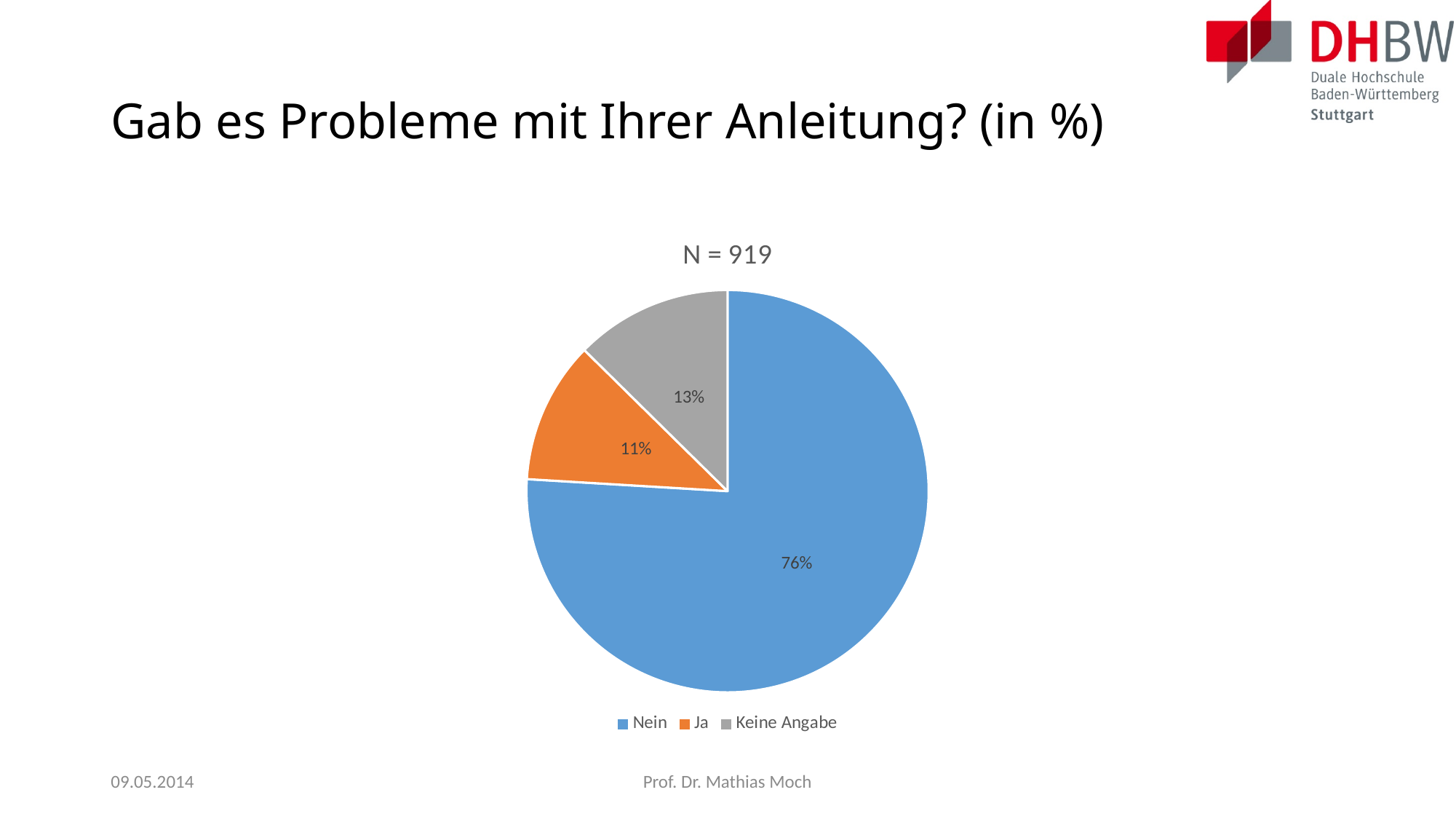
What is the value for "Ja"? 11% What is the value for "Keine Angabe"? 13% Which is larger, the value for "Keine Angabe" or the value for "Ja"? Keine Angabe What is the chart title shown above the pie? N = 919 Which category has the largest slice? Nein What kind of chart is shown on the slide? pie chart What is the value for "Nein"? 76% Which category has the smallest slice? Ja Which colour represents "Ja" in the legend? orange What is the difference between the values for "Keine Angabe" and "Ja"? 2% How many slices does the pie chart have? 3 What is the difference between the values for "Nein" and "Ja"? 65%